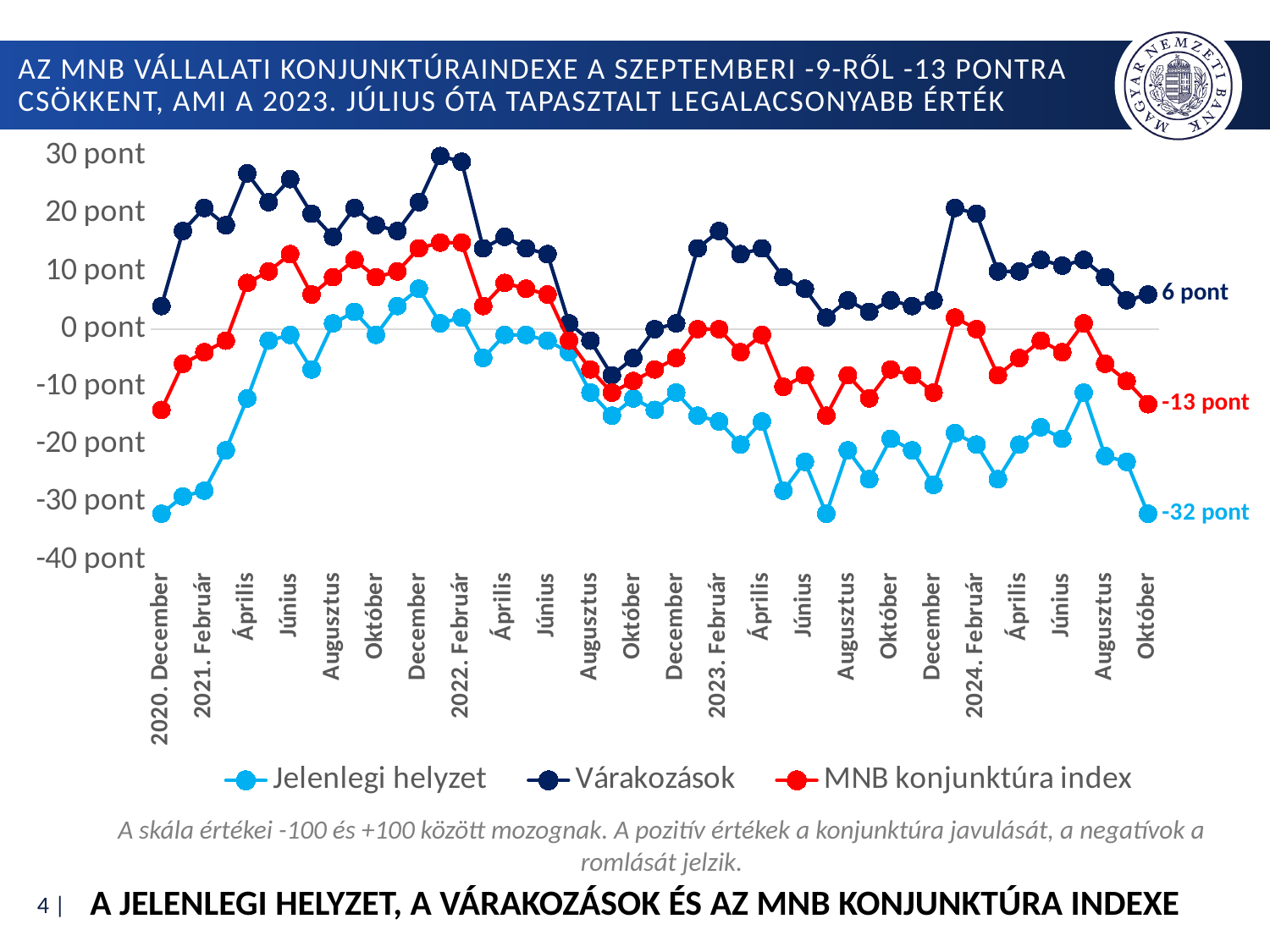
What is the value of the Várakozások series at 2024 Október? 6 pont Is the value of Jelenlegi helyzet at 2020 December greater or less than -20 pont? less At 2024 Október, which series has the higher value: Várakozások or Jelenlegi helyzet? Várakozások Which series has the highest value at 2024 Október? Várakozások Is the value of Várakozások at 2022 Február greater or less than 20 pont? greater How many series does the legend list? 3 What type of chart is shown on the slide? line chart What is the difference between the Várakozások value and the MNB konjunktúra index value at 2024 Október? 19 pont Does the Jelenlegi helyzet series rise or fall between 2024 Augusztus and 2024 Október? fall Which series is drawn in red? MNB konjunktúra index What is the value of the Jelenlegi helyzet series at 2024 Október? -32 pont What is the value of the MNB konjunktúra index at 2024 Október? -13 pont